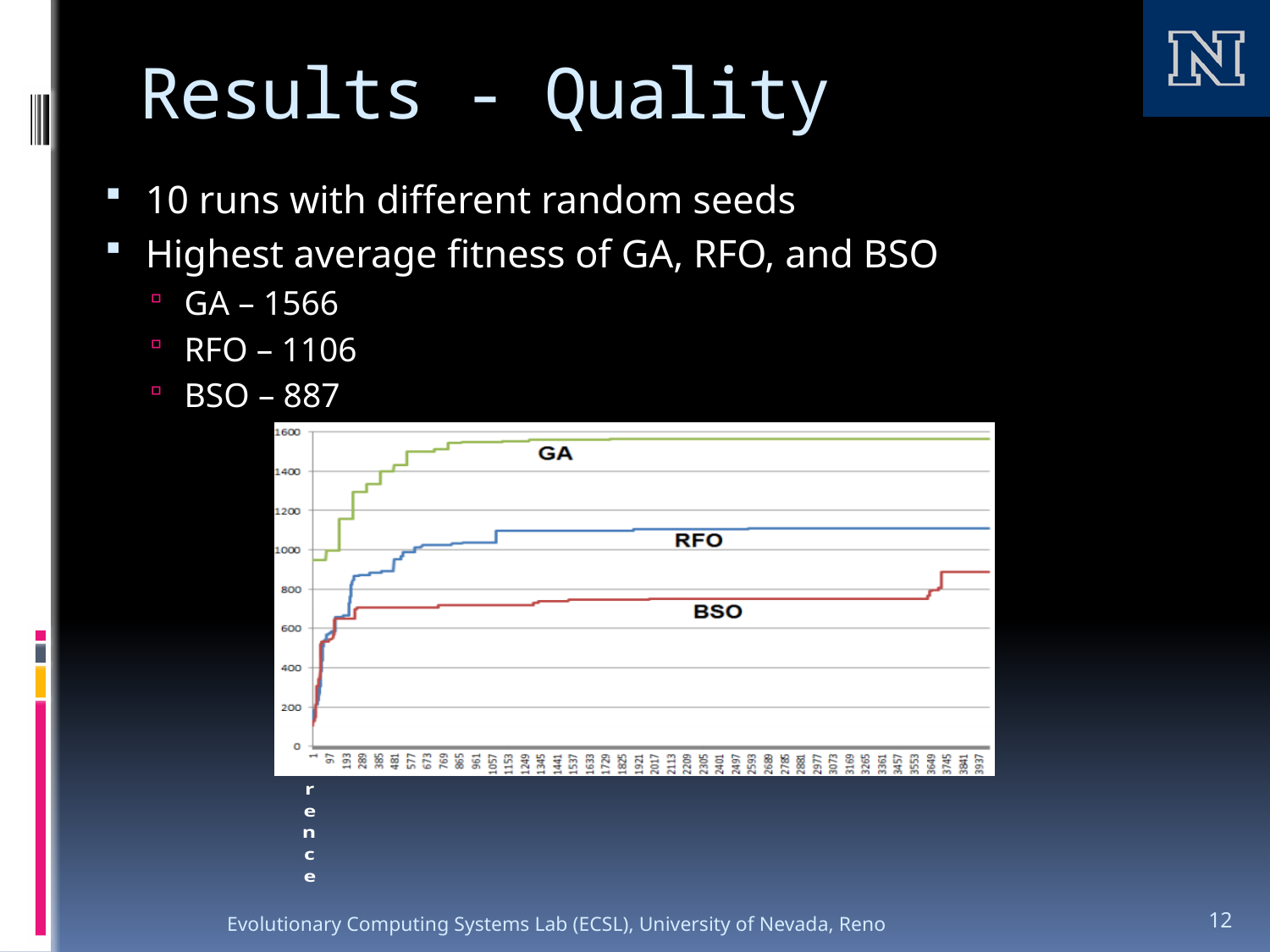
Which algorithm's line has the lowest fitness on the chart? BSO What is the difference between the highest average fitness of GA and RFO? 460 Which reaches a higher fitness on the chart, RFO or BSO? RFO What is the difference between the highest average fitness of RFO and BSO? 219 What is the highest average fitness reached by RFO? 1106 Which algorithm's line reaches the highest fitness on the chart? GA Do the fitness values rise or fall along the x axis for all three algorithms? rise What is the highest average fitness reached by BSO? 887 How many series (algorithms) are plotted on the chart? 3 What is the highest average fitness reached by GA? 1566 Is the final fitness value of the GA line greater or less than 1400? greater What kind of chart is shown on the slide? line chart